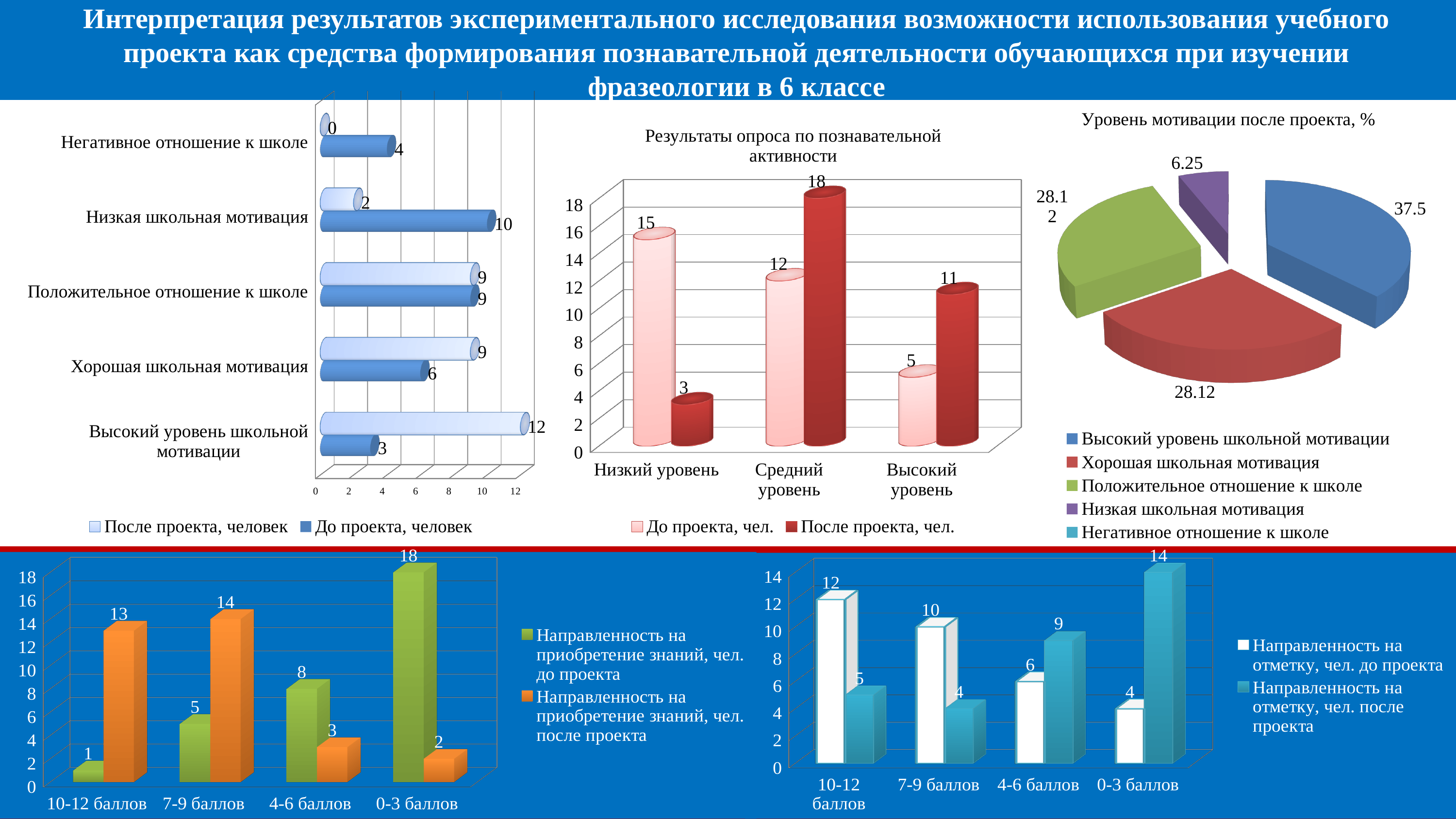
In the pie chart titled 'Уровень мотивации после проекта, %', how many entries does the legend list? 5 In the chart titled 'Результаты опроса по познавательной активности', what is the value for 'Средний уровень' in the 'После проекта, чел.' series? 18 In the bottom-right bar chart, which is larger for '0-3 баллов': the value before the project or the value after the project? after the project In the bottom-right bar chart, what is the total of the two series for '4-6 баллов'? 15 In the pie chart titled 'Уровень мотивации после проекта, %', what is the share for 'Высокий уровень школьной мотивации'? 37.5 In the top-left horizontal bar chart, how many categories are shown? 5 In the pie chart titled 'Уровень мотивации после проекта, %', what is the value of the smallest visible slice? 6.25 In the chart titled 'Результаты опроса по познавательной активности', which category has the highest value in the 'До проекта, чел.' series? Низкий уровень In the top-left horizontal bar chart, which category has the highest value in the 'До проекта, человек' series? Низкая школьная мотивация In the bottom-left bar chart, what is the value for '0-3 баллов' in the 'Направленность на приобретение знаний, чел. до проекта' series? 18 In the chart titled 'Результаты опроса по познавательной активности', what is the difference between the 'До проекта, чел.' and 'После проекта, чел.' values for 'Низкий уровень'? 12 In the top-left horizontal bar chart, what is the value for 'Высокий уровень школьной мотивации' in the 'После проекта, человек' series? 12